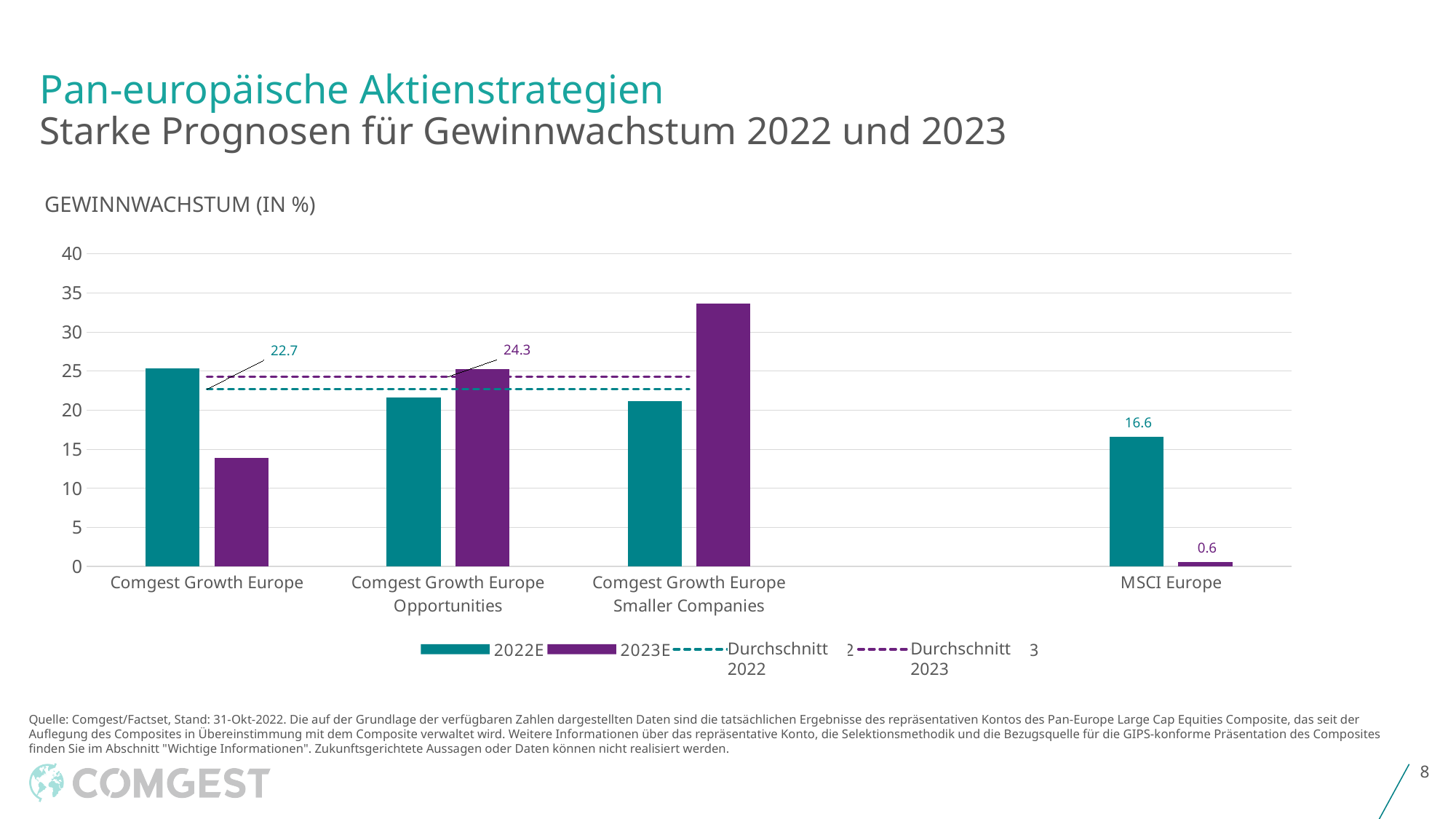
What value is shown for the Durchschnitt 2023 line? 24.3 What is the difference between the 2022E and 2023E values for MSCI Europe? 16.0 Which category has the highest 2023E bar? Comgest Growth Europe Smaller Companies What value is shown for the Durchschnitt 2022 line? 22.7 For Comgest Growth Europe, which is larger: the 2022E bar or the 2023E bar? 2022E Which category has the lowest 2023E bar? MSCI Europe How many categories are shown on the x axis? 4 How many entries does the legend list? 4 What is the 2023E value for MSCI Europe? 0.6 What is the 2022E value for MSCI Europe? 16.6 Is the 2023E value for Comgest Growth Europe Smaller Companies greater or less than 30? greater How much higher is the Durchschnitt 2023 value than the Durchschnitt 2022 value? 1.6